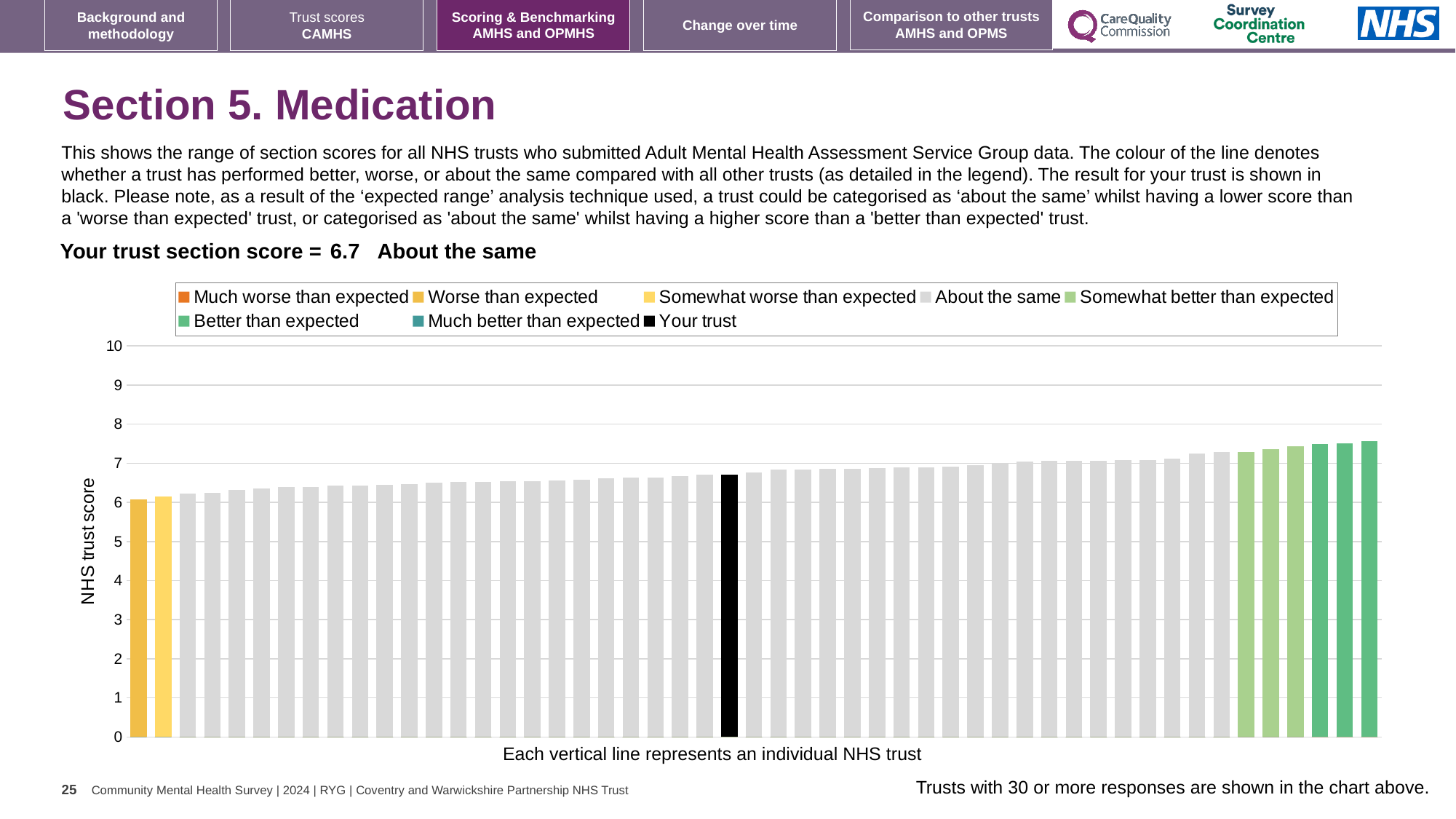
Is the value of the rightmost bar greater or less than 7? greater Which is taller, the leftmost bar or the rightmost bar? the rightmost bar What is the title of the vertical axis? NHS trust score Do the bar values rise or fall from left to right along the x axis? rise Is the value of the black 'Your trust' bar greater or less than 7? less Is the value of the rightmost bar greater or less than 8? less Which category is 'Your trust' placed in according to the slide? About the same What kind of chart is shown on the slide? bar chart How many bars are coloured as 'Worse than expected' (yellow)? 1 How many entries does the chart legend list? 8 What is the section score for 'Your trust' shown on the slide? 6.7